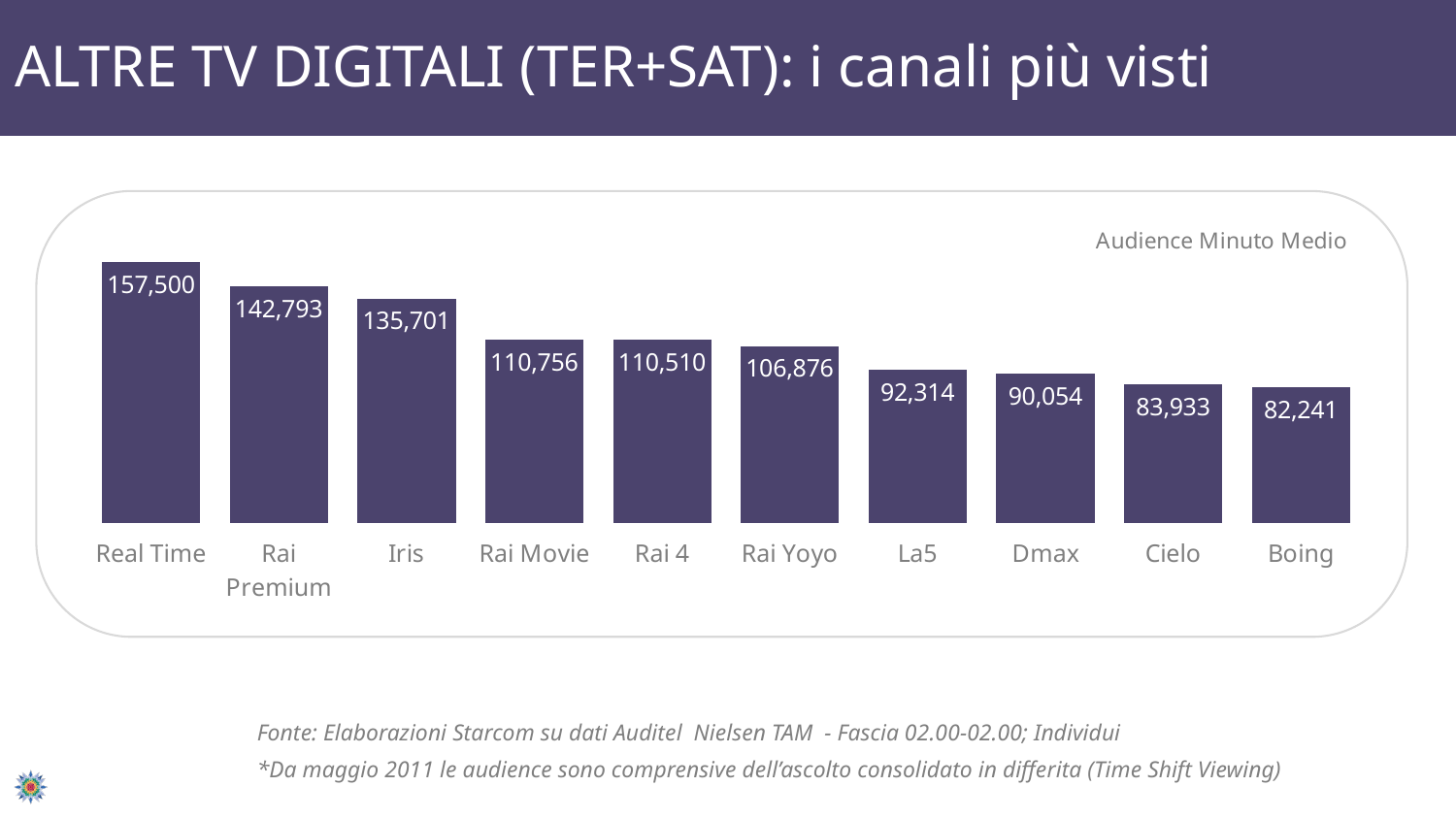
What is the value shown for Rai Yoyo? 106,876 Which has a larger value, La5 or Dmax? La5 What kind of chart is shown on the slide? Bar chart What is the difference between the values for Rai Premium and Iris? 7,092 What is the Audience Minuto Medio value for Real Time? 157,500 Which channel has the highest audience value? Real Time Which channel has the lowest audience value? Boing Do the values rise or fall from left to right across the channels? Fall What is the difference between the values for Real Time and Boing? 75,259 How many channels are shown in the chart? 10 Which has a larger value, Iris or Rai Movie? Iris What is the value shown for Cielo? 83,933